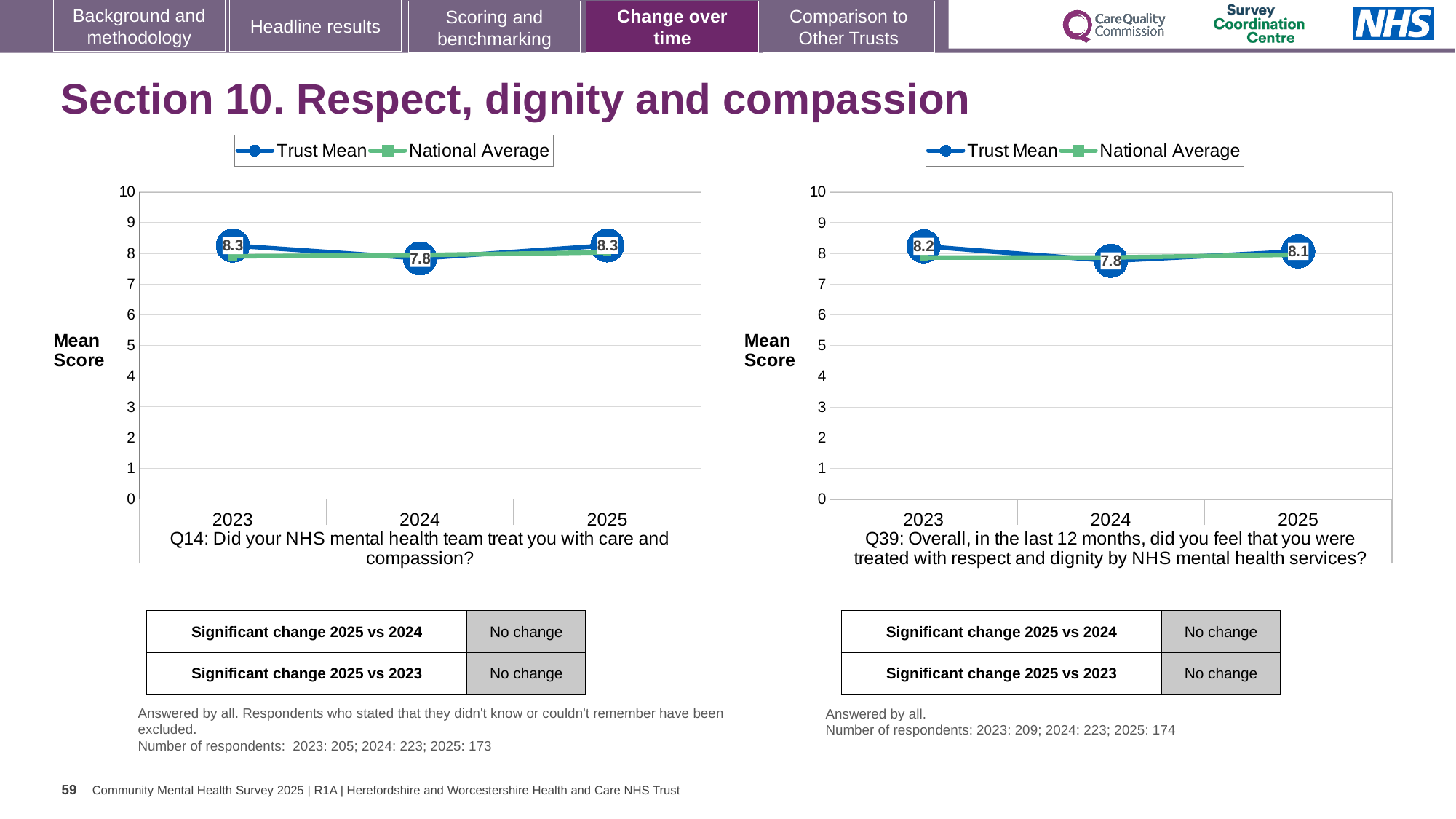
In the Q39 chart (right), what is the difference between the Trust Mean scores for 2023 and 2024? 0.4 What type of chart is the Q14 chart (left)? line chart In the Q14 chart (left), what is the Trust Mean score for 2023? 8.3 In the Q14 chart (left), which year has the lowest Trust Mean score? 2024 In the Q39 chart (right), what is the Trust Mean score for 2023? 8.2 In the Q14 chart (left), is the Trust Mean score for 2025 larger or smaller than the score for 2024? larger How many series does the legend of the Q39 chart (right) list? 2 How many years are plotted on the x axis of the Q14 chart (left)? 3 In the Q39 chart (right), what is the Trust Mean score for 2025? 8.1 In the Q39 chart (right), does the Trust Mean score rise or fall from 2023 to 2024? fall In the Q14 chart (left), what is the Trust Mean score for 2024? 7.8 In the Q39 chart (right), is the National Average value for 2024 greater or less than 9? less